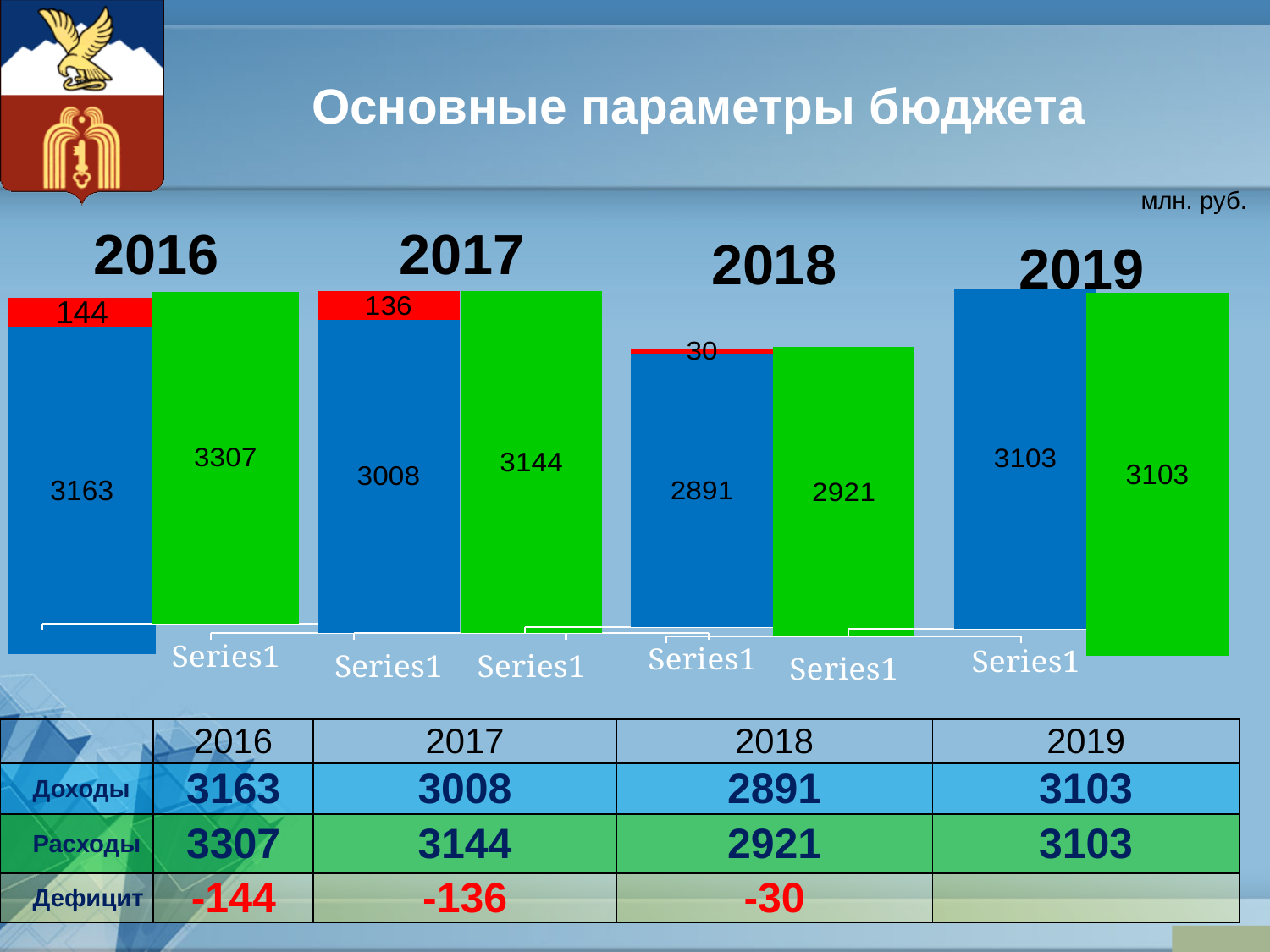
What kind of chart is shown on the slide? bar chart What value is printed on the red segment above the blue bar for 2018? 30 What is the difference between the green bar (3307) and the blue bar (3163) for 2016? 144 Which is larger: the blue bar (Доходы) for 2017 or the blue bar for 2018? 2017 In which year is the blue bar (Доходы) the lowest? 2018 In which year is the green bar (Расходы) the highest? 2016 What is the title of the chart on the slide? Основные параметры бюджета Do the green bars (Расходы) rise or fall from 2016 to 2018? fall What is the value of the blue bar (Доходы) for 2016? 3163 What is the value of the green bar (Расходы) for 2017? 3144 What is the value of the green bar (Расходы) for 2019? 3103 How many years are shown in the chart? 4